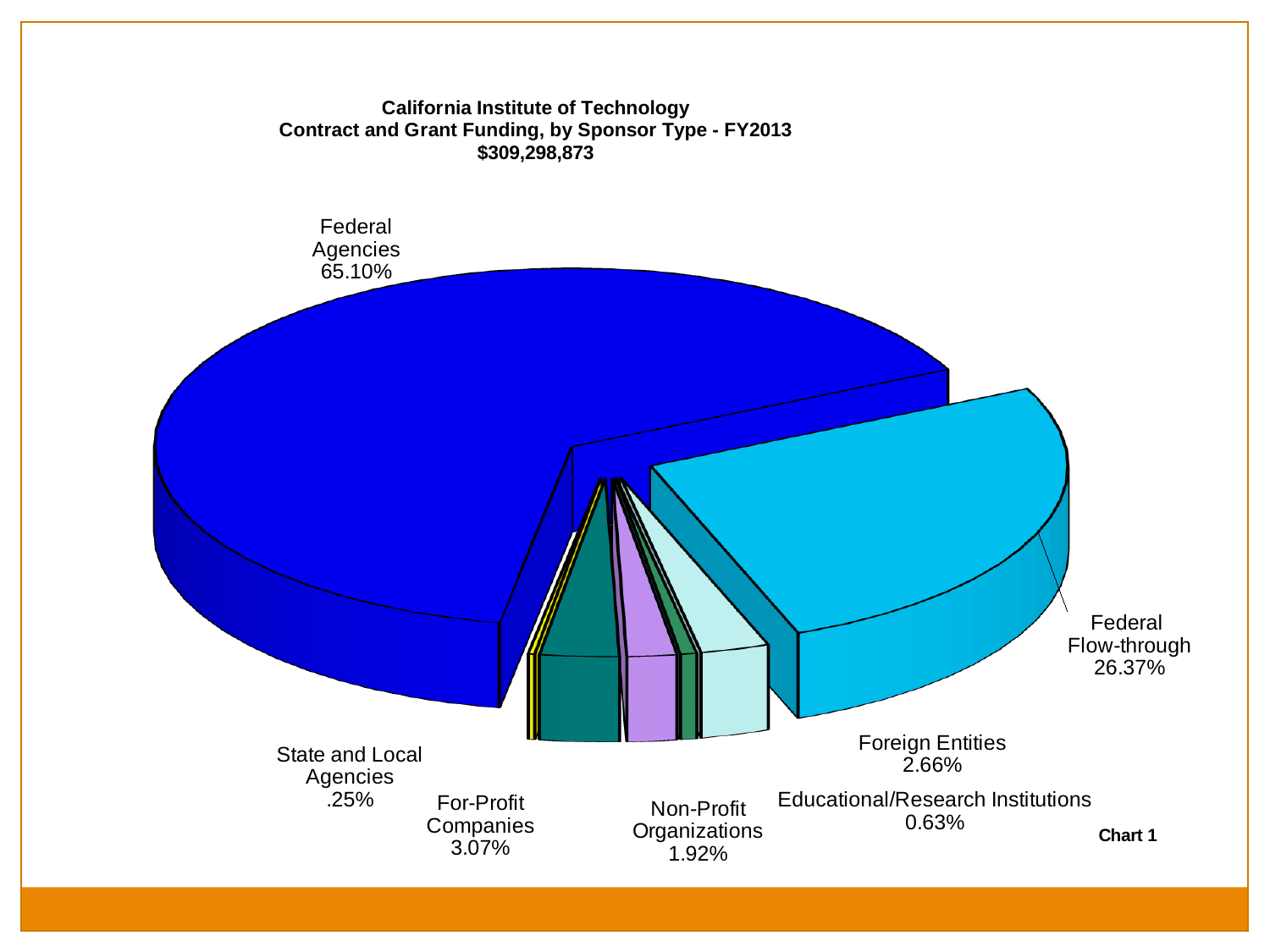
What total funding amount is stated in the chart title? $309,298,873 Which has a larger share, Foreign Entities or Educational/Research Institutions? Foreign Entities What share is shown for Non-Profit Organizations? 1.92% What share of contract and grant funding came from Federal Agencies? 65.10% What percentage is shown for Foreign Entities? 2.66% What kind of chart is shown on the slide? Pie chart Which sponsor type has the largest share of funding? Federal Agencies How many sponsor types are shown in the pie chart? 7 Which sponsor type has the smallest share of funding? State and Local Agencies What share of funding came from For-Profit Companies? 3.07% How many percentage points larger is the Federal Agencies share than the Federal Flow-through share? 38.73 What percentage of funding is attributed to Federal Flow-through? 26.37%